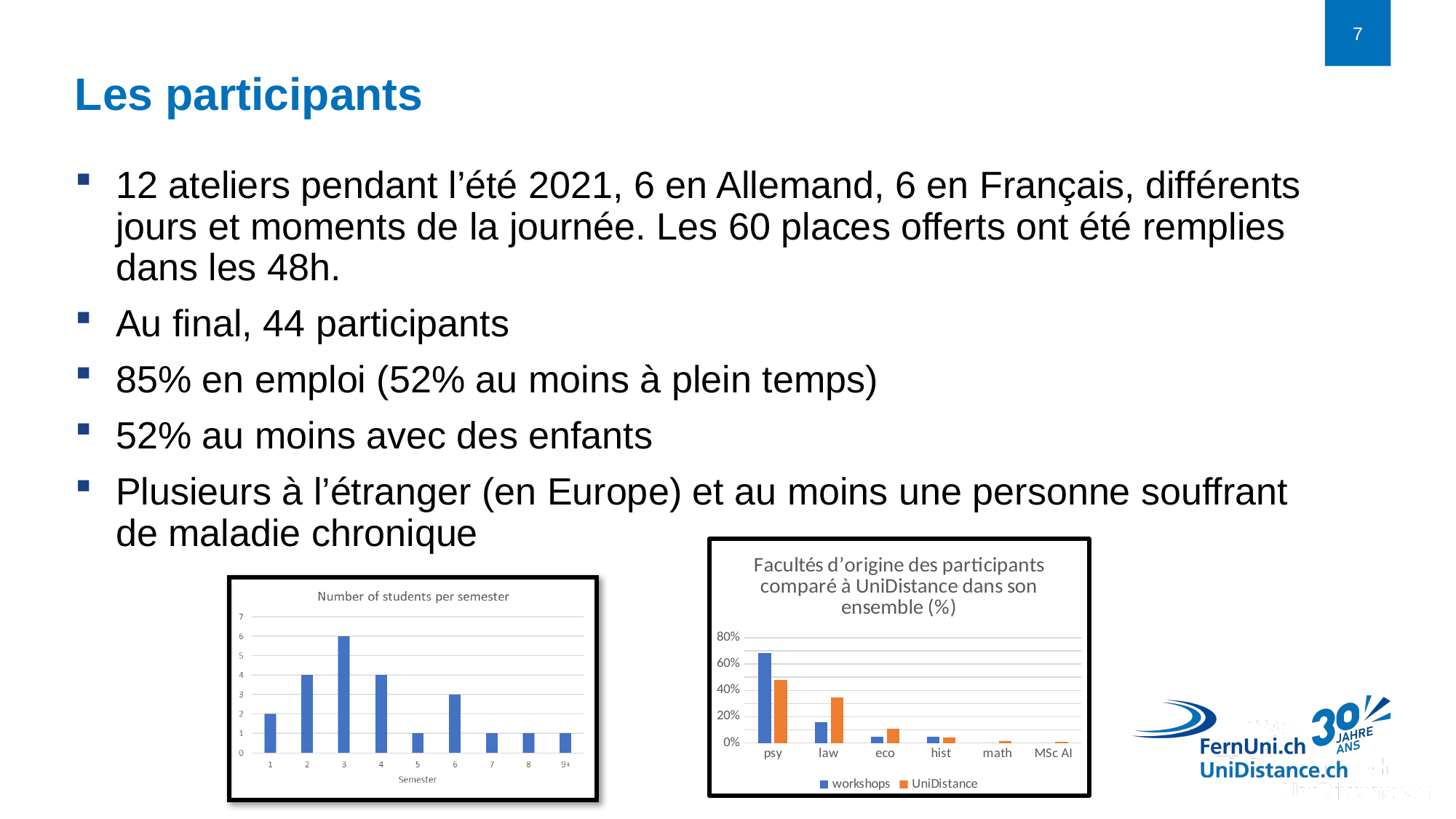
In the 'Number of students per semester' chart, how many students are in semester 1? 2 In the 'Facultés d'origine des participants' chart, is the workshops value for psy greater or less than 60%? greater What kind of chart is the 'Number of students per semester' chart? Bar chart In the 'Number of students per semester' chart, which has more students, semester 2 or semester 5? Semester 2 In the 'Number of students per semester' chart, which semester has the highest number of students? 3 In the 'Number of students per semester' chart, how many students are in semester 6? 3 In the 'Number of students per semester' chart, how many students are in semester 3? 6 In the 'Facultés d'origine des participants' chart, how many series does the legend list? 2 In the 'Facultés d'origine des participants' chart, which series is shown in orange? UniDistance In the 'Facultés d'origine des participants' chart, which faculty has the highest workshops value? psy In the 'Number of students per semester' chart, how many semester categories are shown on the x axis? 9 In the 'Facultés d'origine des participants' chart, is the UniDistance value for law greater or less than 20%? greater